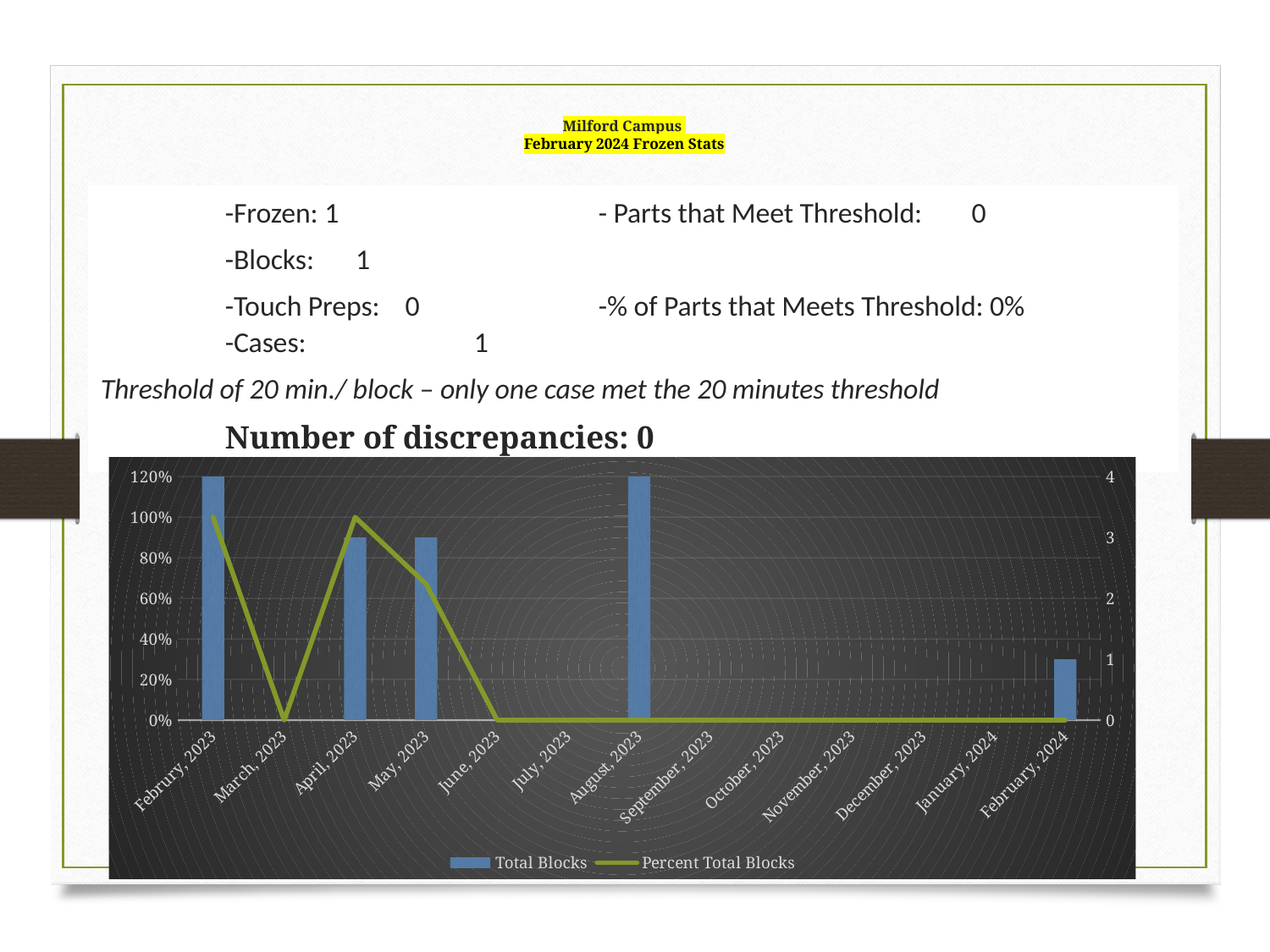
How many months are shown along the x axis of the chart? 13 What is the Total Blocks value for February, 2024? 1 What kind of chart is shown on the slide? A combined bar and line chart Which has the larger Total Blocks value, February, 2023 or February, 2024? February, 2023 Does the Percent Total Blocks line rise or fall from May, 2023 to June, 2023? fall What is the Percent Total Blocks value for March, 2023? 0% What is the Percent Total Blocks value for April, 2023? 100% How many series does the chart legend list? 2 Is the Percent Total Blocks value for May, 2023 greater or less than 40%? greater What are the two series named in the chart legend? Total Blocks and Percent Total Blocks What is the Total Blocks value for April, 2023? 3